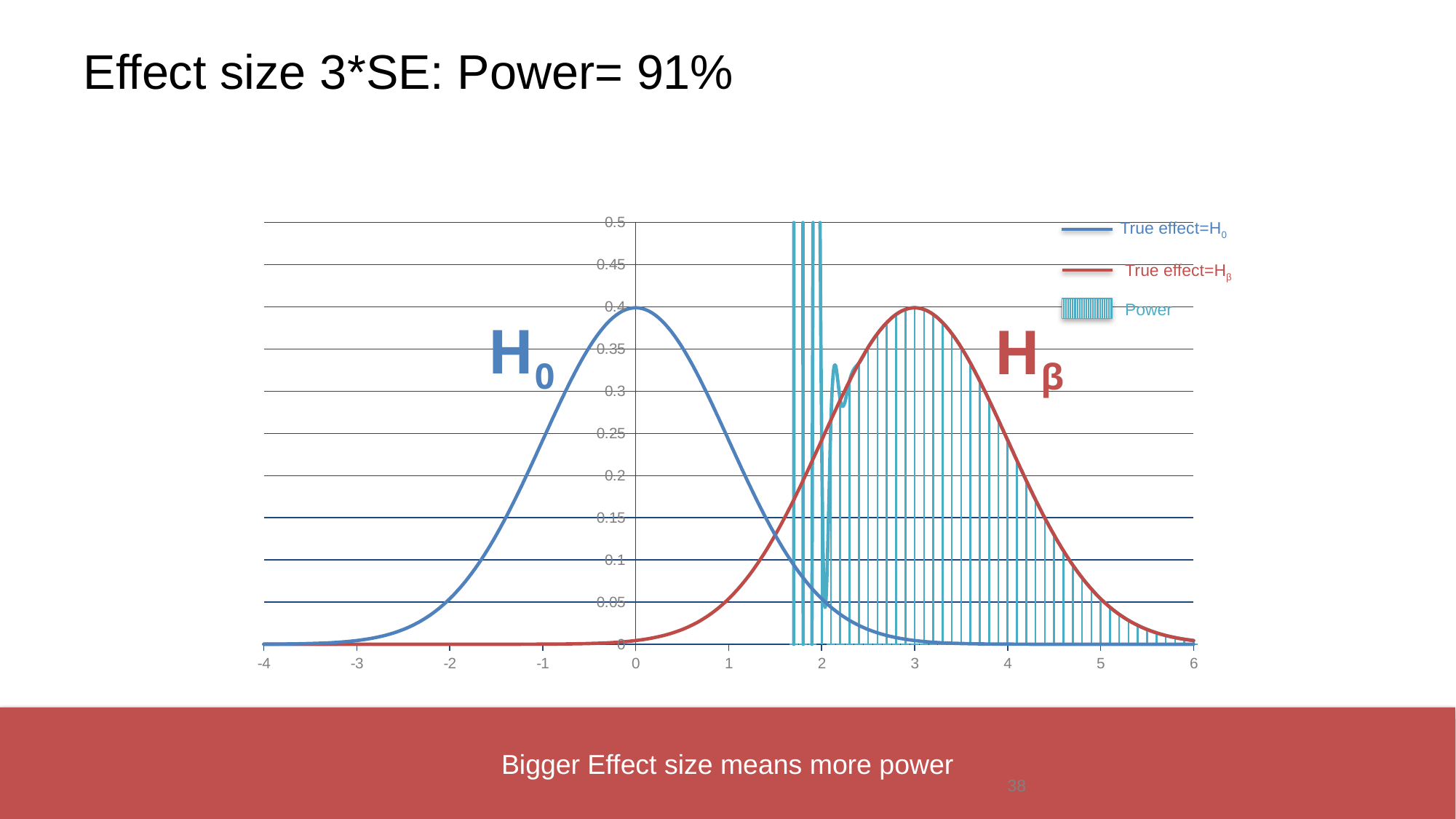
Does the blue H0 curve rise or fall as x goes from 0 to 6? Fall Is the value of the red Hβ curve at x = 0 greater or less than 0.05? less At which x value does the red Hβ curve reach its peak? 3 How many entries does the chart legend list? 3 At x = 1, which curve is higher, the blue H0 curve or the red Hβ curve? Blue H0 curve At which x value does the blue H0 curve reach its peak? 0 Which legend entry is drawn in blue? True effect=H0 What is the highest value labelled on the y axis? 0.5 How many tick labels are shown on the x axis? 11 Is the peak value of the blue H0 curve greater or less than 0.35? greater What kind of chart is shown on the slide? Line chart At x = 4, which curve is higher, the blue H0 curve or the red Hβ curve? Red Hβ curve